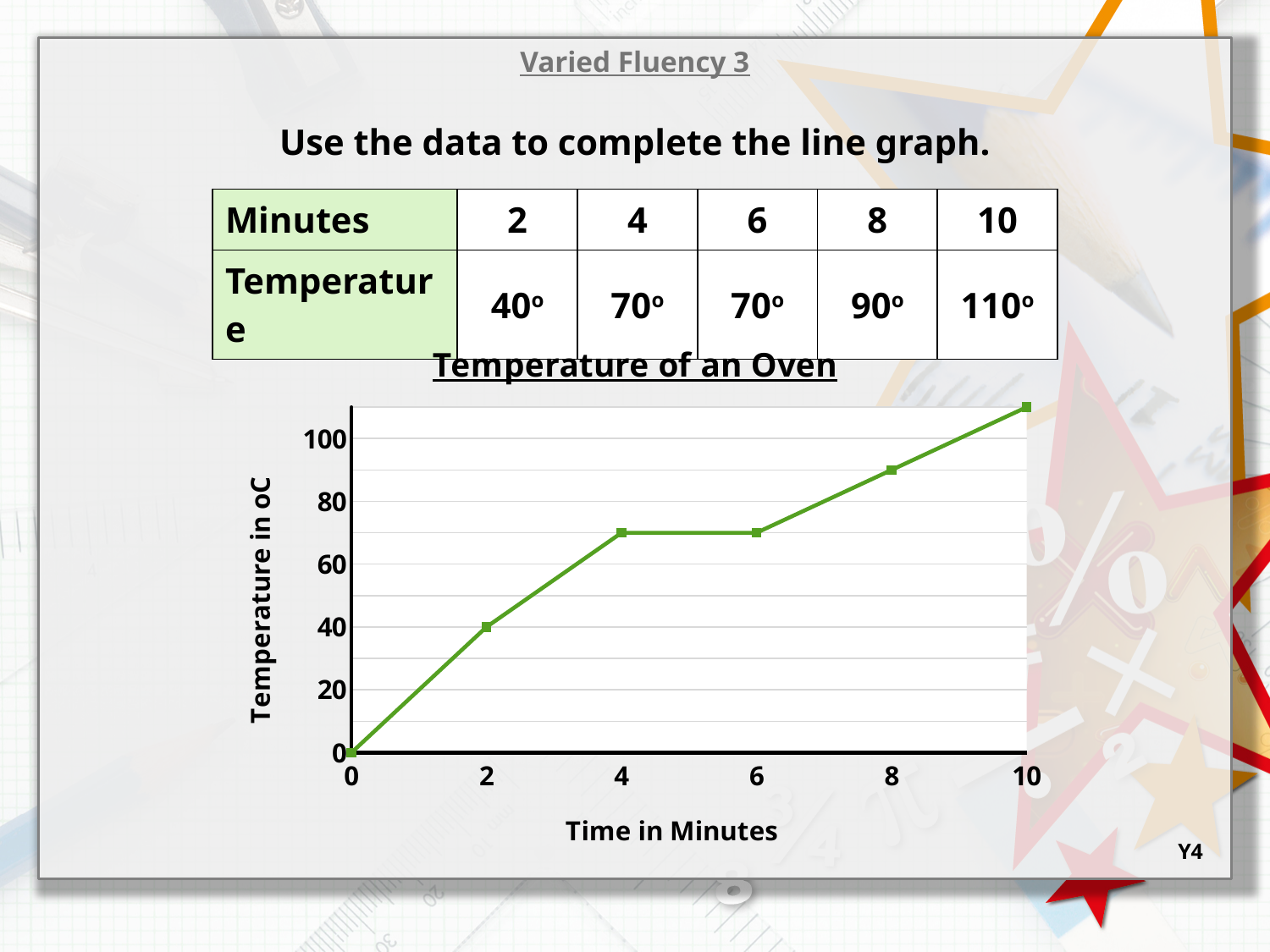
Which is higher, the temperature at 8 minutes or the temperature at 4 minutes? 8 minutes Is the temperature at 4 minutes greater or less than 60? greater At which time in minutes is the oven temperature highest? 10 What is the temperature of the oven at 2 minutes? 40° What is the label on the vertical axis of the chart? Temperature in oC How many points are plotted on the line graph? 6 What is the temperature of the oven at 8 minutes? 90° What is the temperature of the oven at 10 minutes? 110° What kind of chart is shown on the slide? line chart At which time in minutes is the oven temperature lowest? 0 Does the temperature generally rise or fall as time in minutes increases? rise What is the difference between the temperature at 10 minutes and the temperature at 2 minutes? 70°